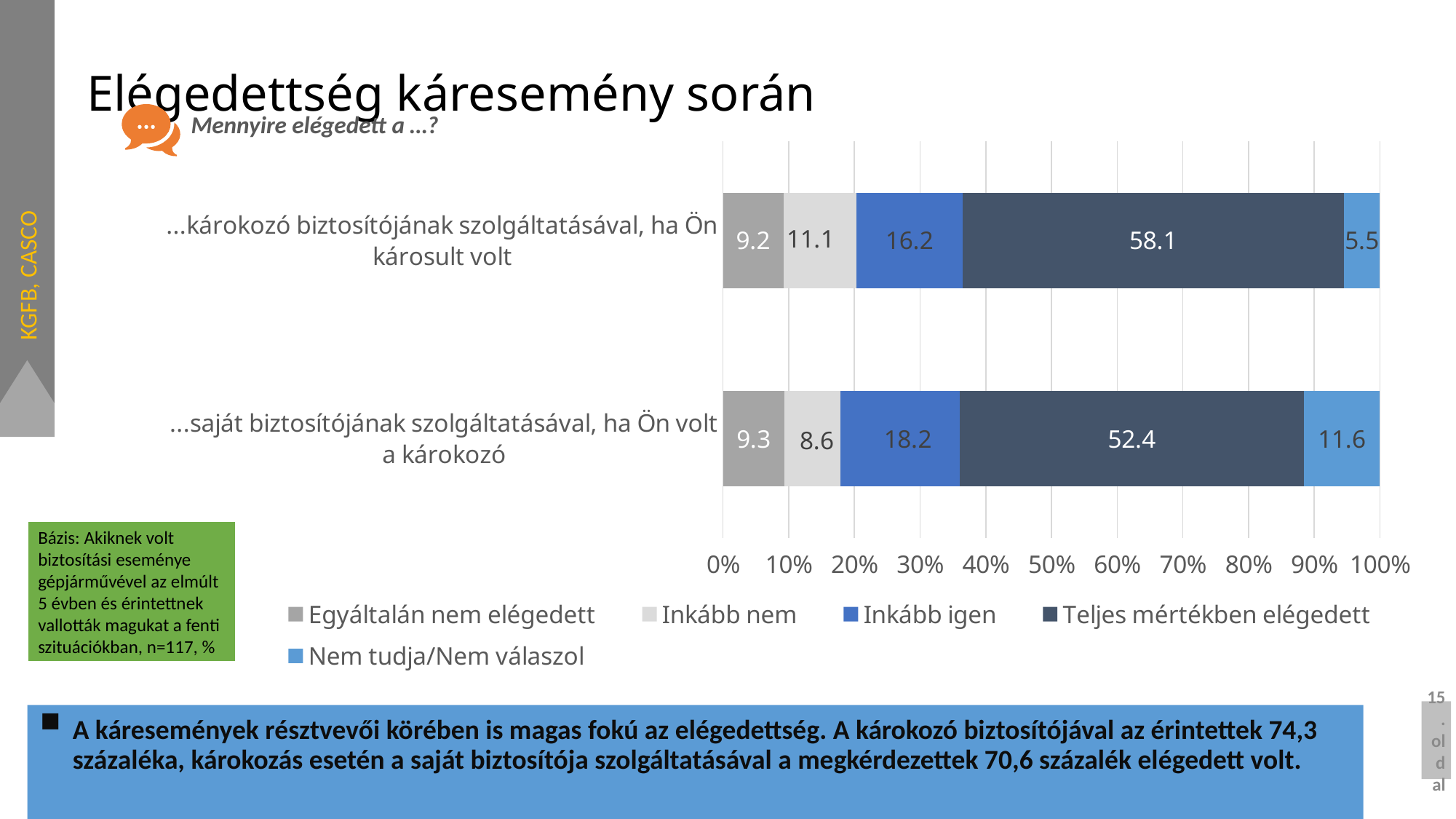
What is the difference between the 'Inkább igen' values of the two categories? 2.0 What is the value of 'Egyáltalán nem elégedett' for '...saját biztosítójának szolgáltatásával, ha Ön volt a károkozó'? 9.3 Which is larger: 'Nem tudja/Nem válaszol' for '...saját biztosítójának szolgáltatásával, ha Ön volt a károkozó' or for '...károkozó biztosítójának szolgáltatásával, ha Ön károsult volt'? ...saját biztosítójának szolgáltatásával, ha Ön volt a károkozó How many series does the legend list? 5 What is the difference between the 'Teljes mértékben elégedett' values of the two categories? 5.7 How many categories (bars) are plotted in the chart? 2 Which category has the higher 'Teljes mértékben elégedett' value? ...károkozó biztosítójának szolgáltatásával, ha Ön károsult volt What is the value of 'Nem tudja/Nem válaszol' for '...saját biztosítójának szolgáltatásával, ha Ön volt a károkozó'? 11.6 What is the value of 'Teljes mértékben elégedett' for '...károkozó biztosítójának szolgáltatásával, ha Ön károsult volt'? 58.1 What type of chart is shown on the slide? stacked bar chart What is the value of 'Inkább nem' for '...károkozó biztosítójának szolgáltatásával, ha Ön károsult volt'? 11.1 Which series in the legend is shown in the darkest colour? Teljes mértékben elégedett